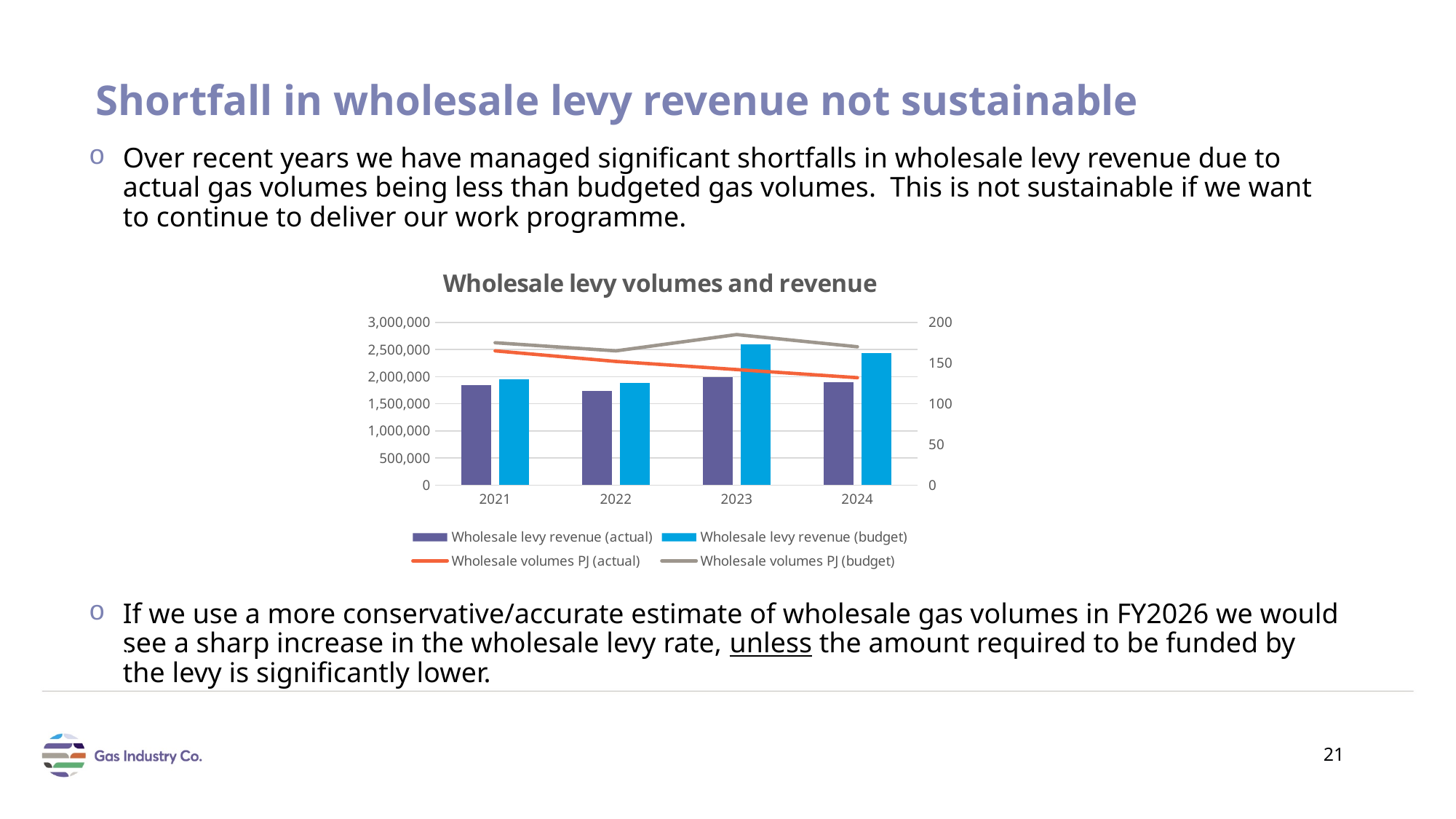
In which year is the Wholesale levy revenue (actual) bar the lowest? 2022 Is the Wholesale levy revenue (actual) value for 2022 greater or less than 2,000,000? less What is the title of the chart? Wholesale levy volumes and revenue Does the Wholesale volumes PJ (actual) line rise or fall from 2021 to 2024? Falls In which year is the Wholesale levy revenue (budget) bar the highest? 2023 What kind of chart is shown on the slide? A combined bar and line chart Is the Wholesale volumes PJ (actual) value for 2024 greater or less than 150? less How many years are shown on the x axis of the chart? 4 In 2023, which is larger: Wholesale levy revenue (actual) or Wholesale levy revenue (budget)? Wholesale levy revenue (budget) Which series is drawn as an orange line in the chart? Wholesale volumes PJ (actual) Is the Wholesale levy revenue (budget) value for 2023 greater or less than 2,500,000? greater How many series does the chart legend list? 4